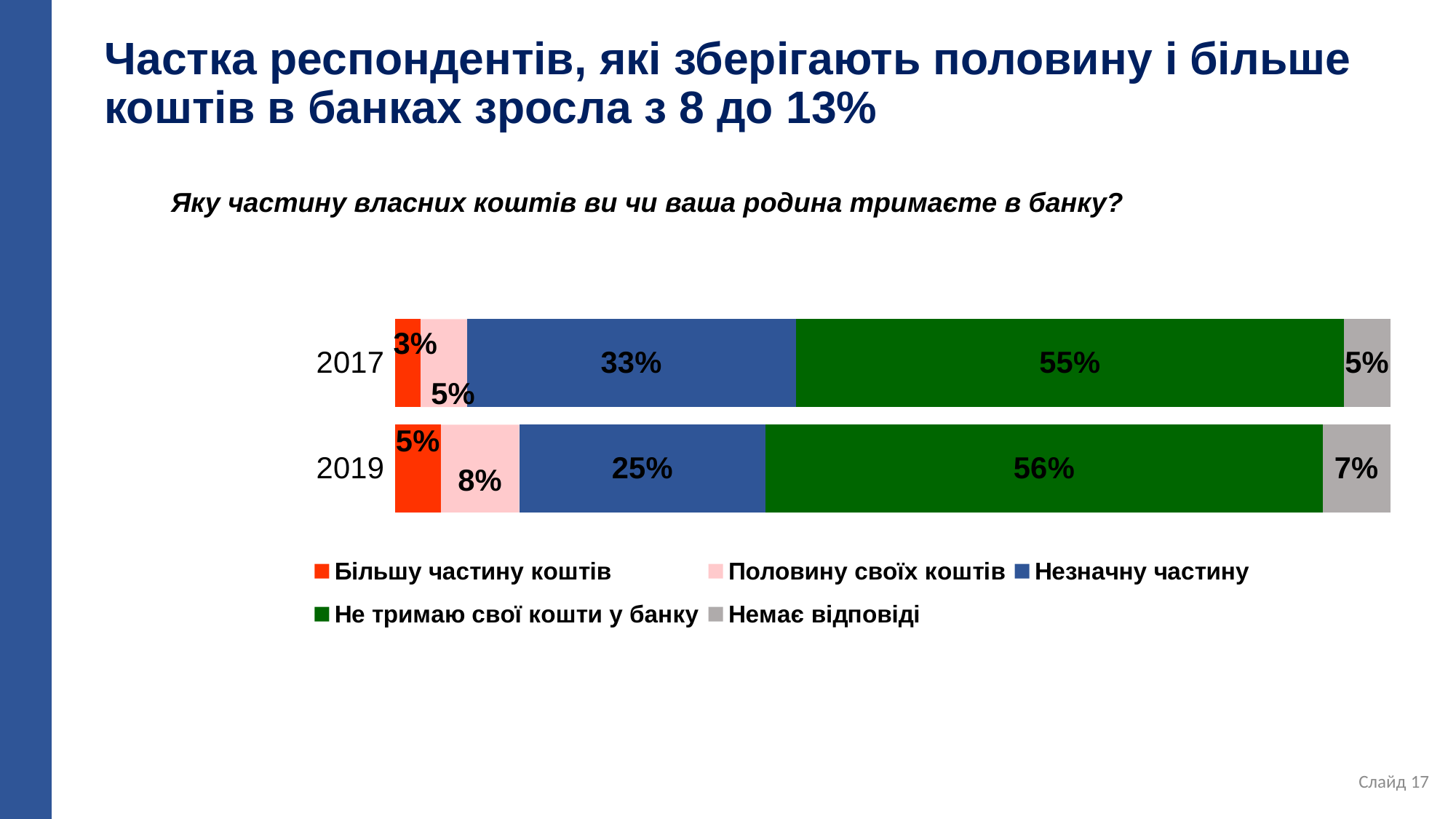
What is the value for "Не тримаю свої кошти у банку" in 2019? 56% What kind of chart is shown on the slide? Stacked bar chart What colour represents "Не тримаю свої кошти у банку" in the chart? Green What is the value for "Незначну частину" in 2017? 33% Which response category has the largest share in 2019? Не тримаю свої кошти у банку By how many percentage points did "Незначну частину" change from 2017 to 2019? Decreased by 8 percentage points (33% to 25%) How many years (categories) are shown in the chart? 2 What is the value for "Немає відповіді" in 2017? 5% Which response category has the smallest share in 2017? Більшу частину коштів What is the value for "Половину своїх коштів" in 2019? 8% How many series does the legend list? 5 Which year has the larger value for "Більшу частину коштів", 2017 or 2019? 2019